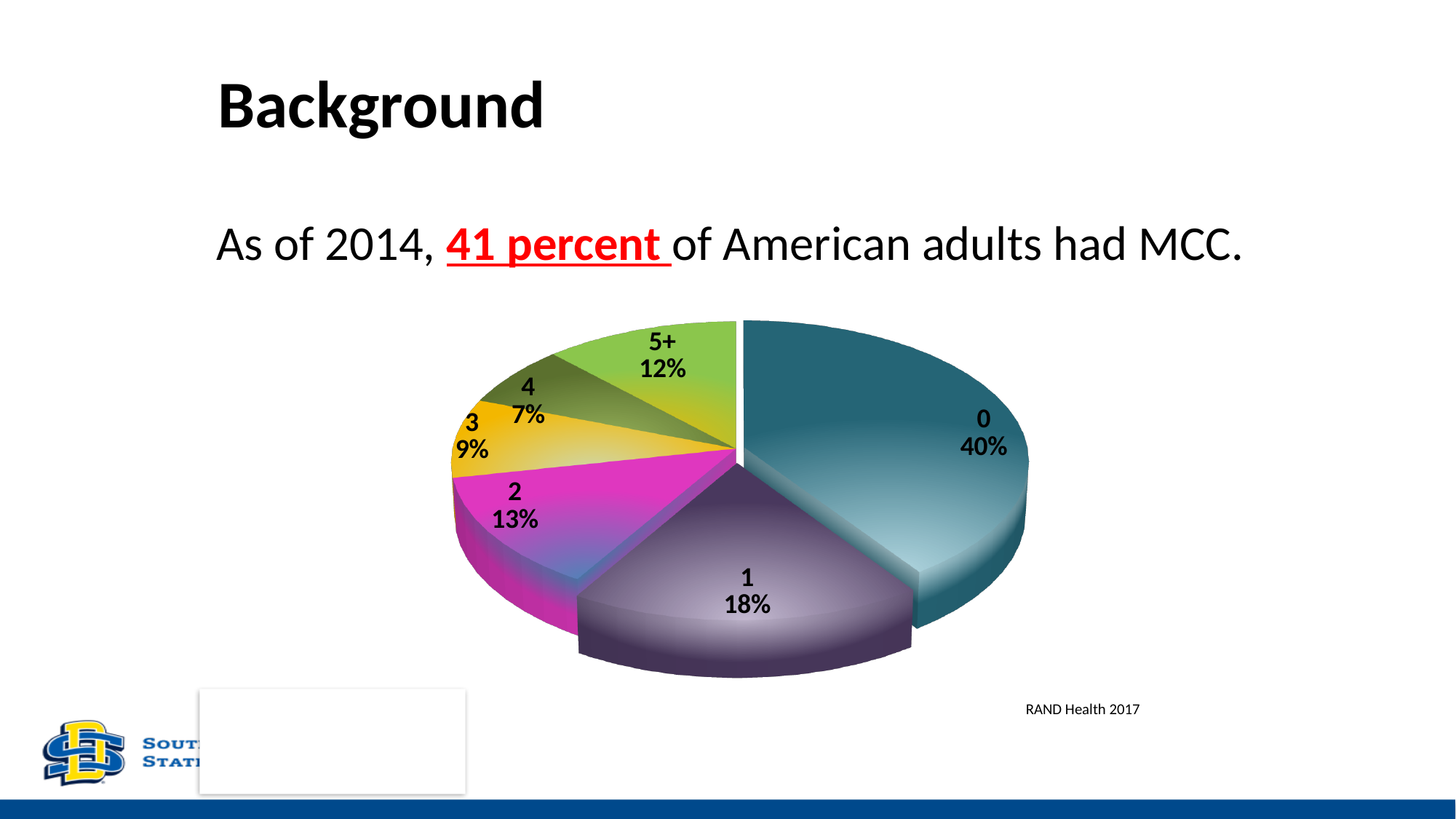
What percentage of the pie is the slice labelled 4? 7% What is the difference in percentage points between the slice labelled 0 and the slice labelled 1? 22 Which slice is larger, the one labelled 3 or the one labelled 4? 3 What percentage of the pie is the slice labelled 2? 13% What percentage of the pie is the slice labelled 1? 18% What source is cited below the chart? RAND Health 2017 Which slice of the pie is the largest? 0 What type of chart is shown on the slide? pie chart How many slices does the pie chart have? 6 What percentage of the pie is the slice labelled 0? 40% Which slice of the pie is the smallest? 4 What percentage of the pie is the slice labelled 5+? 12%